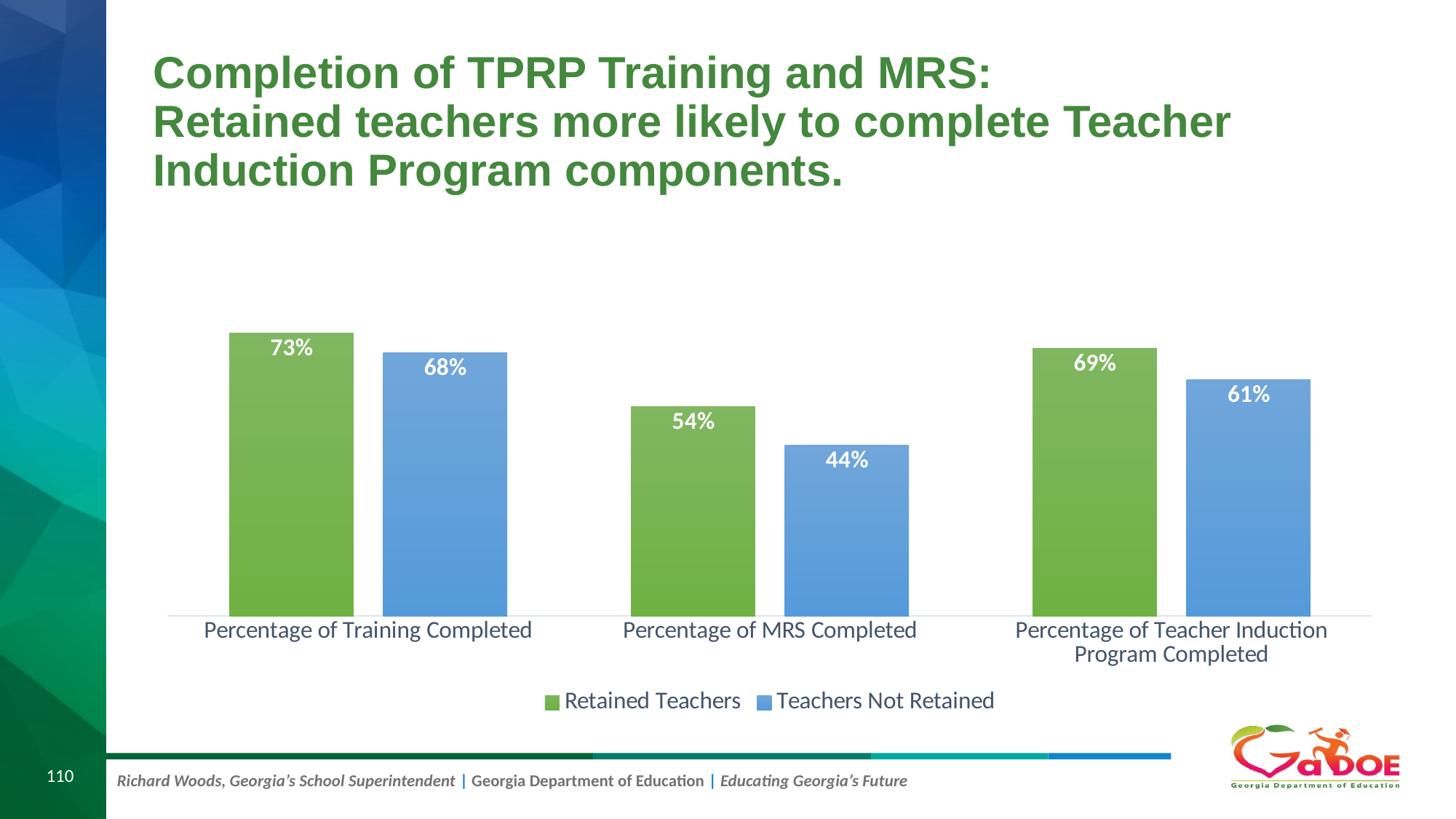
Which category has the highest value for Retained Teachers? Percentage of Training Completed Which category has the lowest value for Teachers Not Retained? Percentage of MRS Completed How many categories are shown on the x axis? 3 What is the difference between Retained Teachers and Teachers Not Retained for Percentage of Teacher Induction Program Completed? 8% What percentage of Retained Teachers completed Training? 73% Which colour represents Teachers Not Retained in the chart? Blue What kind of chart is shown on the slide? Bar chart What percentage of Teachers Not Retained completed the Teacher Induction Program? 61% What is the value for Teachers Not Retained in the Percentage of MRS Completed category? 44% What is the difference between Retained Teachers and Teachers Not Retained for Percentage of MRS Completed? 10% How many series does the legend list? 2 Which is larger for Percentage of Training Completed: Retained Teachers or Teachers Not Retained? Retained Teachers